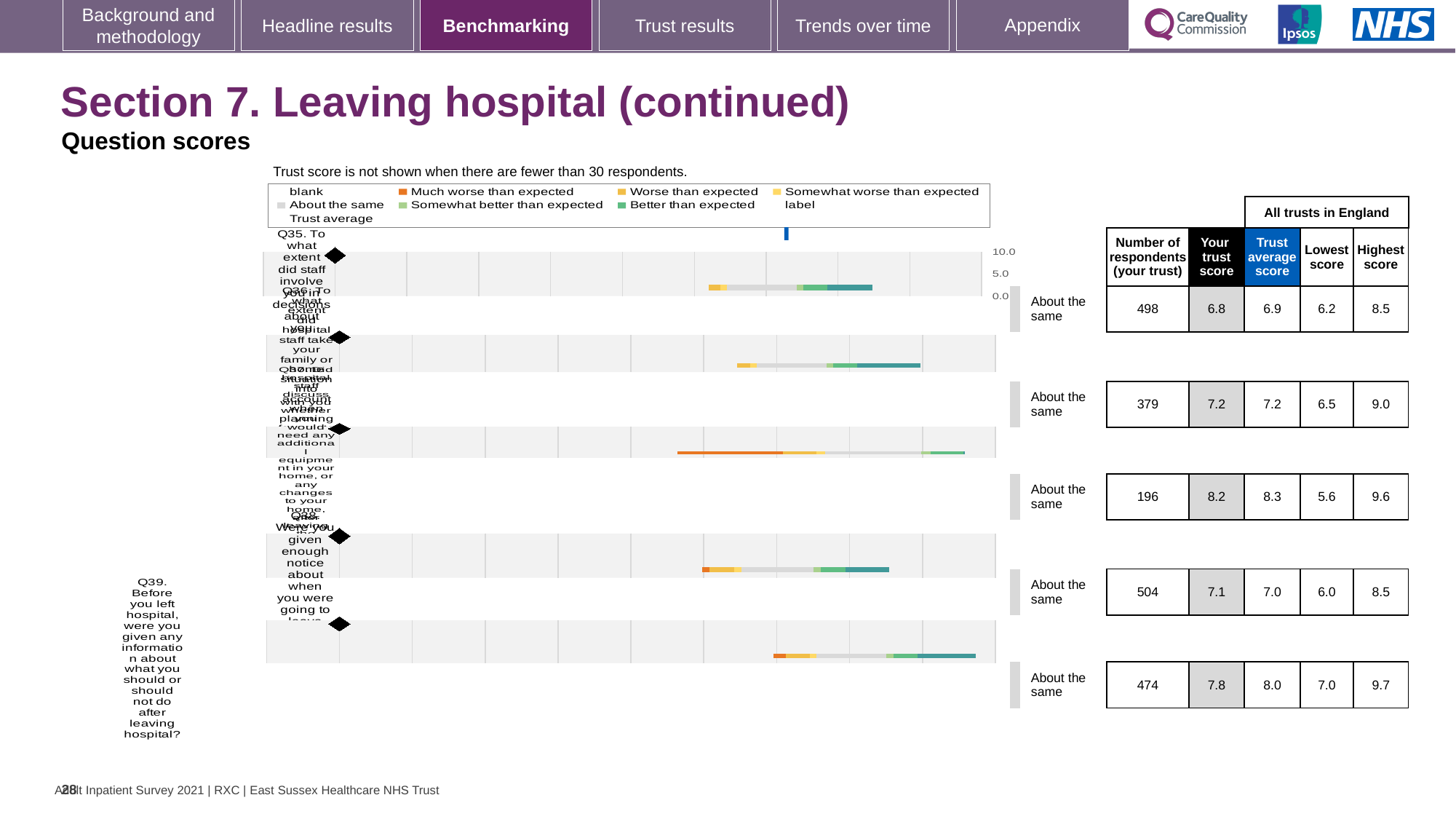
What is the trust average score for Q38? 7.0 What is the difference between the trust average score and your trust score for Q39? 0.2 For Q37, which is larger: your trust score or the trust average score? Trust average score What is the 'Your trust score' for Q39 (information about what you should or should not do after leaving hospital)? 7.8 Which question has the lowest 'Your trust score'? Q35 Which question has the highest 'Your trust score'? Q37 Which question has the largest number of respondents (your trust)? Q38 What is the lowest score across all trusts in England for Q37? 5.6 What is the highest score across all trusts in England for Q36? 9.0 How many respondents (your trust) are shown for Q35? 498 What benchmark category is shown for every question on this slide? About the same How many questions are plotted on the chart? 5